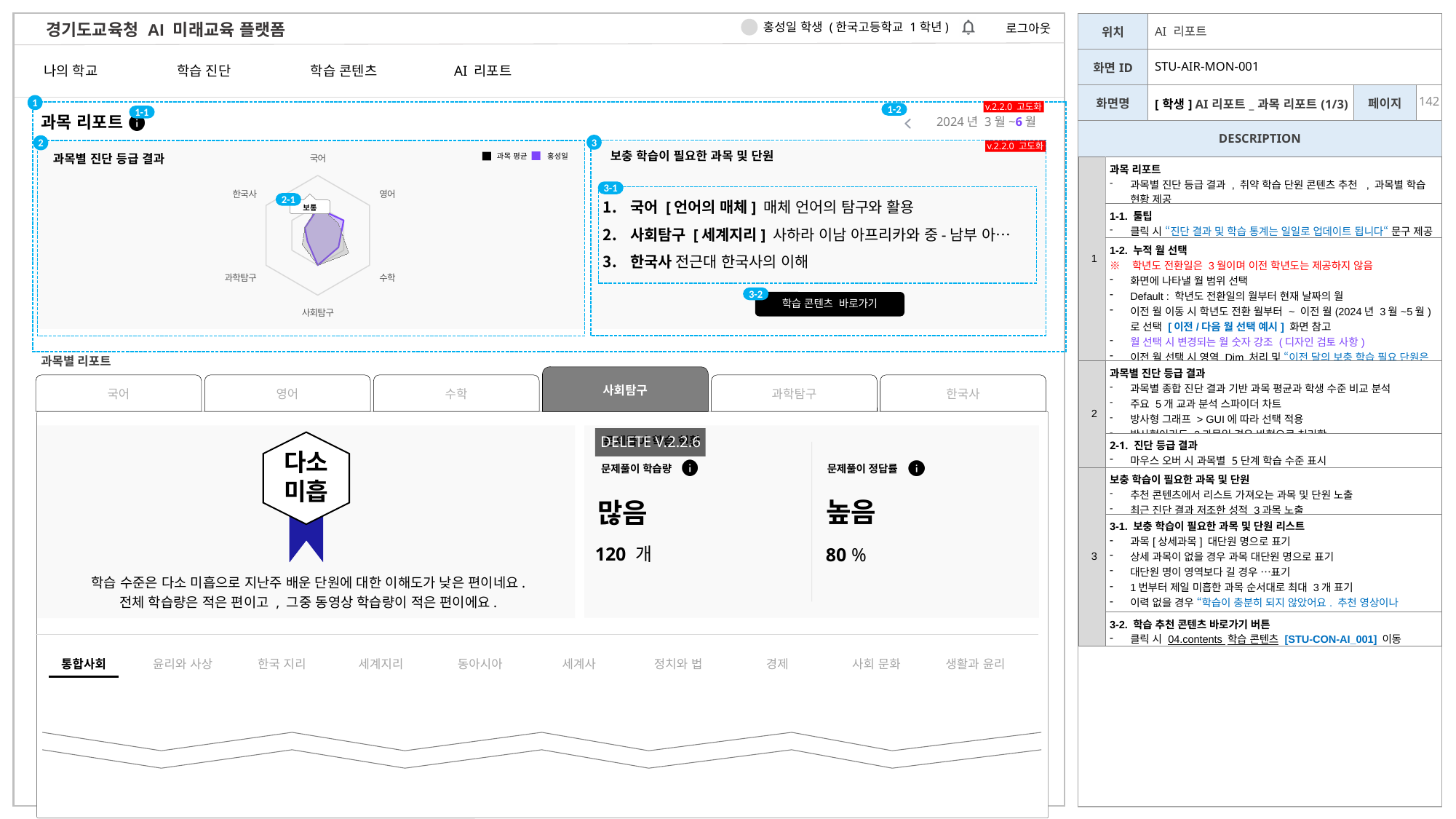
Which subject label appears at the bottom of the radar chart? 사회탐구 What text is shown in the tooltip on the radar chart near the 국어 axis? 보통 How many subject axes does the radar chart have? 6 What are the two series named in the radar chart's legend? 과목 평균, 홍성일 Which subject label appears at the top of the radar chart? 국어 How many series does the legend of the radar chart list? 2 What is the title of the chart panel containing the radar chart? 과목별 진단 등급 결과 What kind of chart is shown under the heading 과목별 진단 등급 결과? radar chart